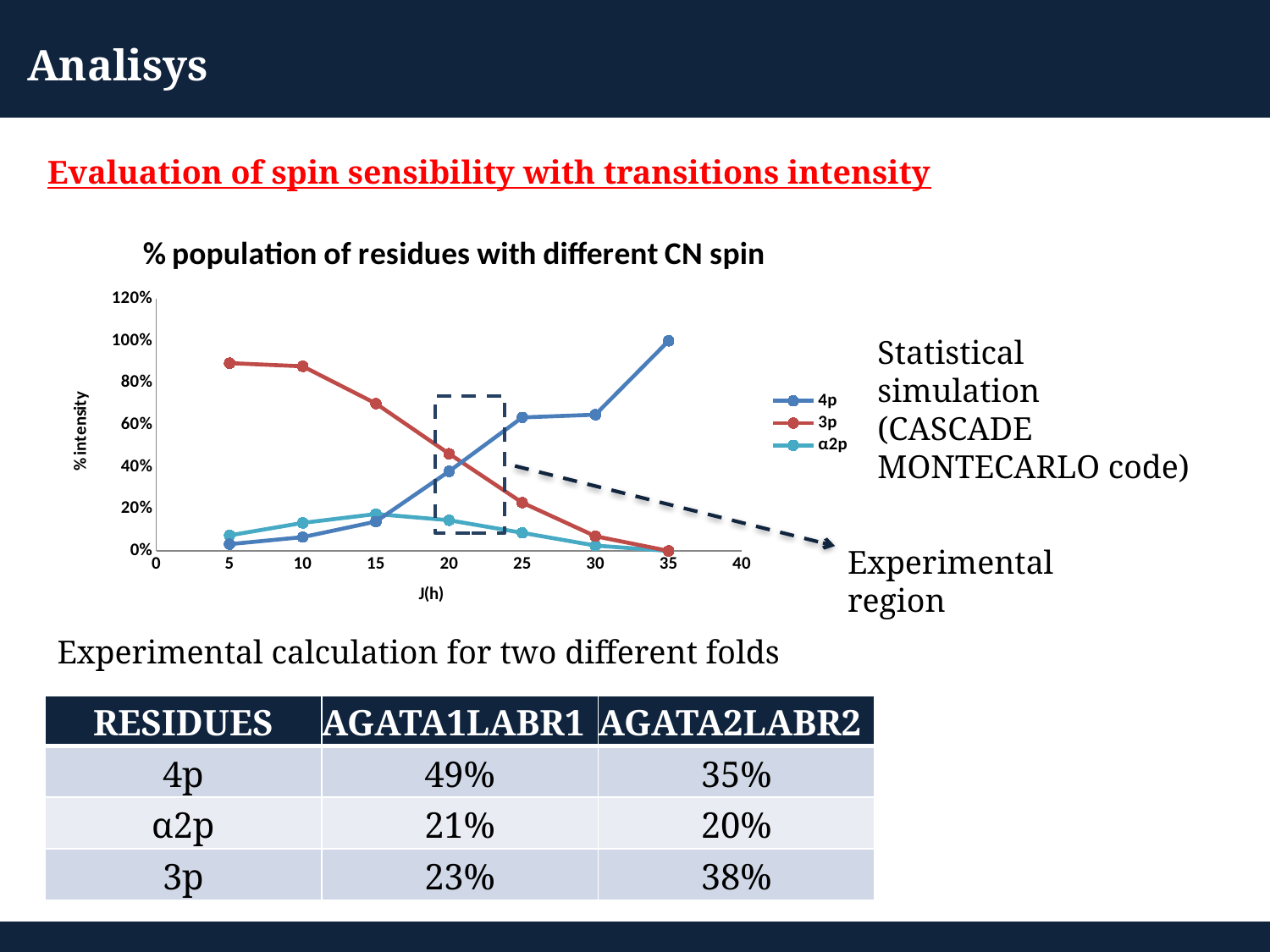
How many series does the chart legend list? 3 What is the title of the chart? % population of residues with different CN spin Which series are listed in the chart legend? 4p, 3p, α2p Is the value of the α2p series at J(h) = 15 greater or less than 40%? less What kind of chart is shown on the slide? line chart Does the 4p series rise or fall as J(h) increases? rise Is the value of the 4p series at J(h) = 35 greater or less than 80%? greater Is the value of the 3p series at J(h) = 5 greater or less than 80%? greater At J(h) = 10, which series has the larger value, 3p or 4p? 3p How many data points are plotted for the 4p series? 7 Which series has the highest value at J(h) = 35? 4p Does the 3p series rise or fall as J(h) increases? fall